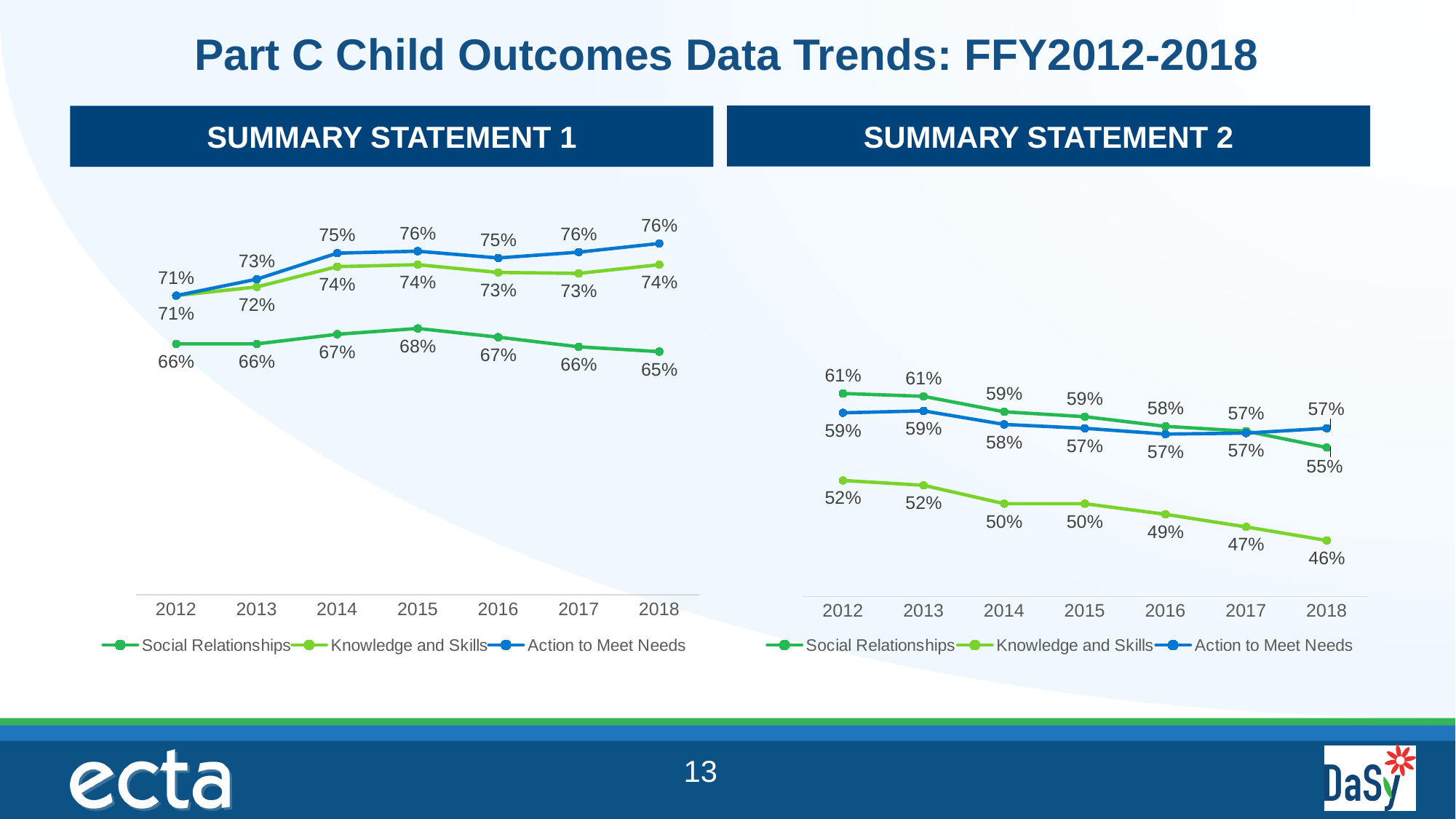
In the Summary Statement 2 chart, which year has the lowest value for Knowledge and Skills? 2018 In the Summary Statement 2 chart, what is the value for Knowledge and Skills in 2018? 46% In the Summary Statement 1 chart, which is larger in 2014: Action to Meet Needs or Knowledge and Skills? Action to Meet Needs What kind of chart is the Summary Statement 2 chart? Line chart In the Summary Statement 1 chart, what is the value for Social Relationships in 2015? 68% In the Summary Statement 2 chart, what is the difference between Social Relationships and Knowledge and Skills in 2012? 9% How many series does the legend of the Summary Statement 1 chart list? 3 In the Summary Statement 2 chart, what is the value for Social Relationships in 2012? 61% In the Summary Statement 2 chart, does the Knowledge and Skills line rise or fall from 2012 to 2018? Fall In the Summary Statement 1 chart, what is the value for Action to Meet Needs in 2018? 76% How many years are shown on the x axis of the Summary Statement 2 chart? 7 In the Summary Statement 1 chart, which year has the highest value for Social Relationships? 2015